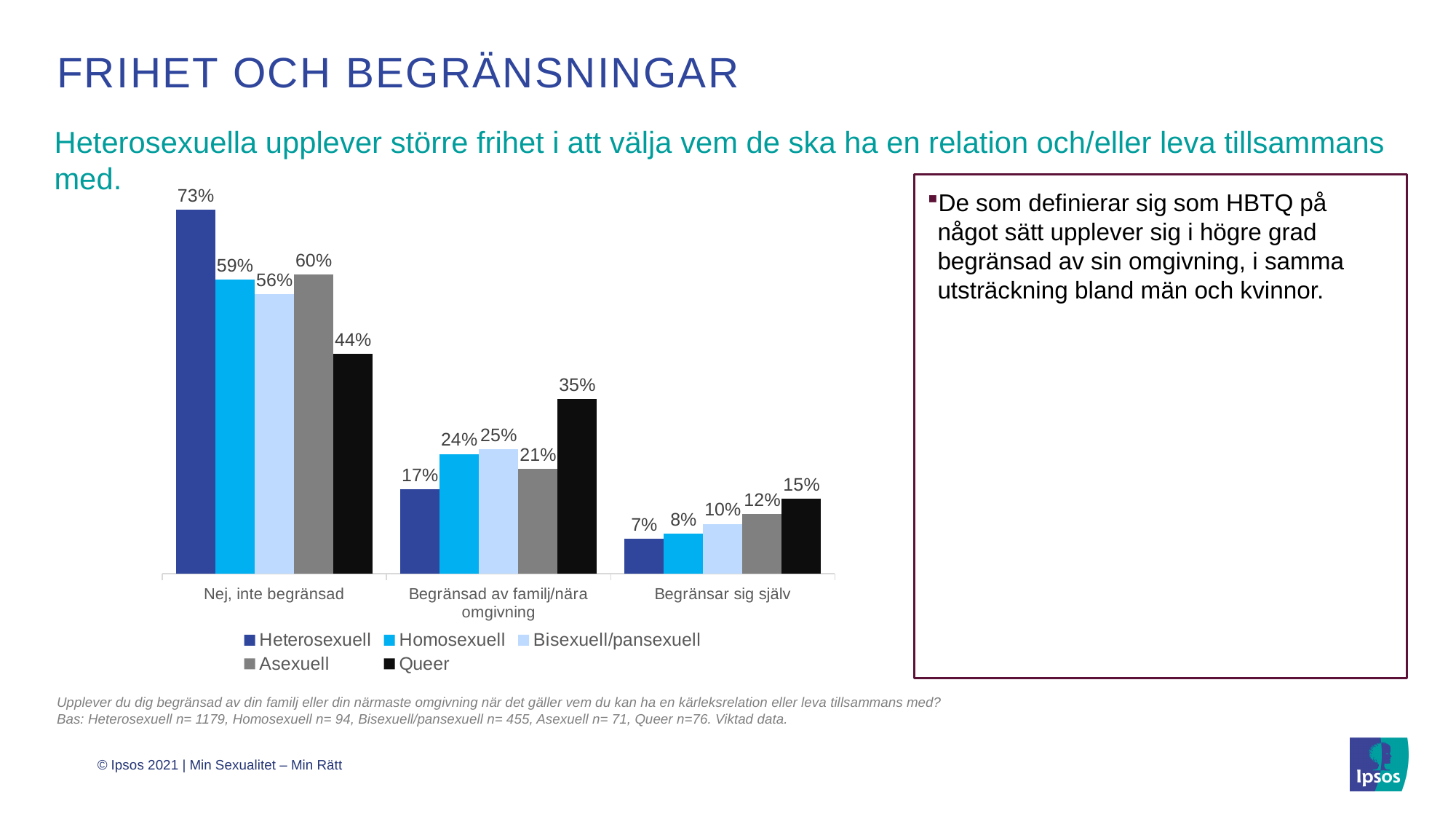
How many categories are shown on the x axis? 3 What is the value for Queer in the 'Begränsad av familj/nära omgivning' category? 35% What kind of chart is shown on the slide? Bar chart Which series is shown in black in the legend? Queer Which series has the highest value in the 'Nej, inte begränsad' category? Heterosexuell What is the value for Asexuell in the 'Begränsar sig själv' category? 12% Which series has the lowest value in the 'Begränsar sig själv' category? Heterosexuell What is the difference between the Heterosexuell and Queer values in the 'Nej, inte begränsad' category? 29% How many series does the legend list? 5 What is the value for Heterosexuell in the 'Nej, inte begränsad' category? 73% Which is larger in the 'Begränsad av familj/nära omgivning' category: Homosexuell or Asexuell? Homosexuell Do the Heterosexuell values rise or fall across the categories from left to right? Fall